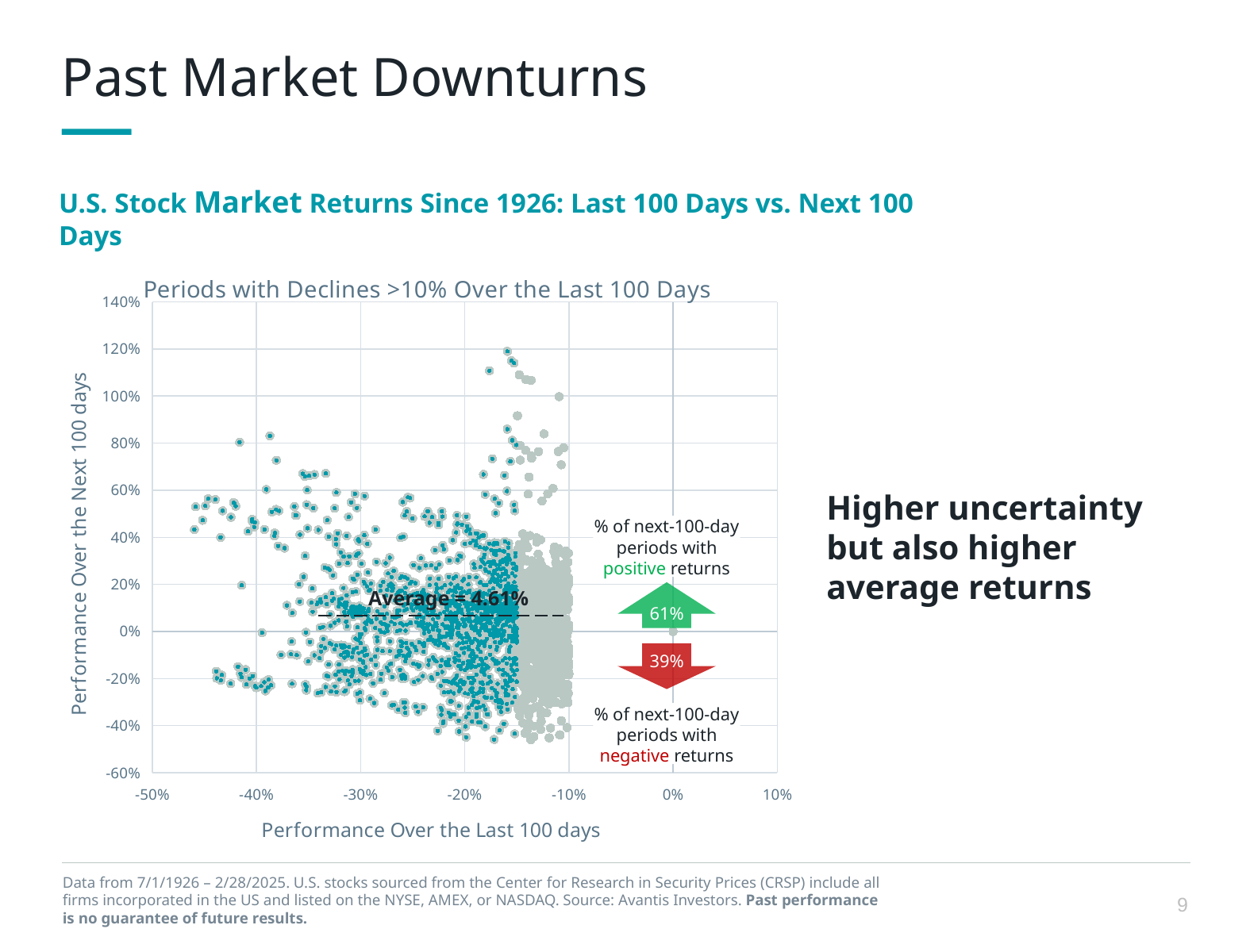
What is the average performance over the next 100 days shown by the dashed line on the chart? 4.61% What is the lowest value shown on the x axis of the chart? -50% Is the average performance over the next 100 days greater or less than 0%? greater What kind of chart is shown on the slide? Scatter chart What is the label of the x axis of the chart? Performance Over the Last 100 days What is the title of the chart? Periods with Declines >10% Over the Last 100 Days What percentage of next-100-day periods had negative returns according to the chart? 39% Which is larger: the share of next-100-day periods with positive returns or the share with negative returns? Positive returns What is the highest value shown on the y axis of the chart? 140% Is the average performance over the next 100 days greater or less than 20%? less What is the difference between the share of next-100-day periods with positive returns and the share with negative returns? 22% What percentage of next-100-day periods had positive returns according to the chart? 61%